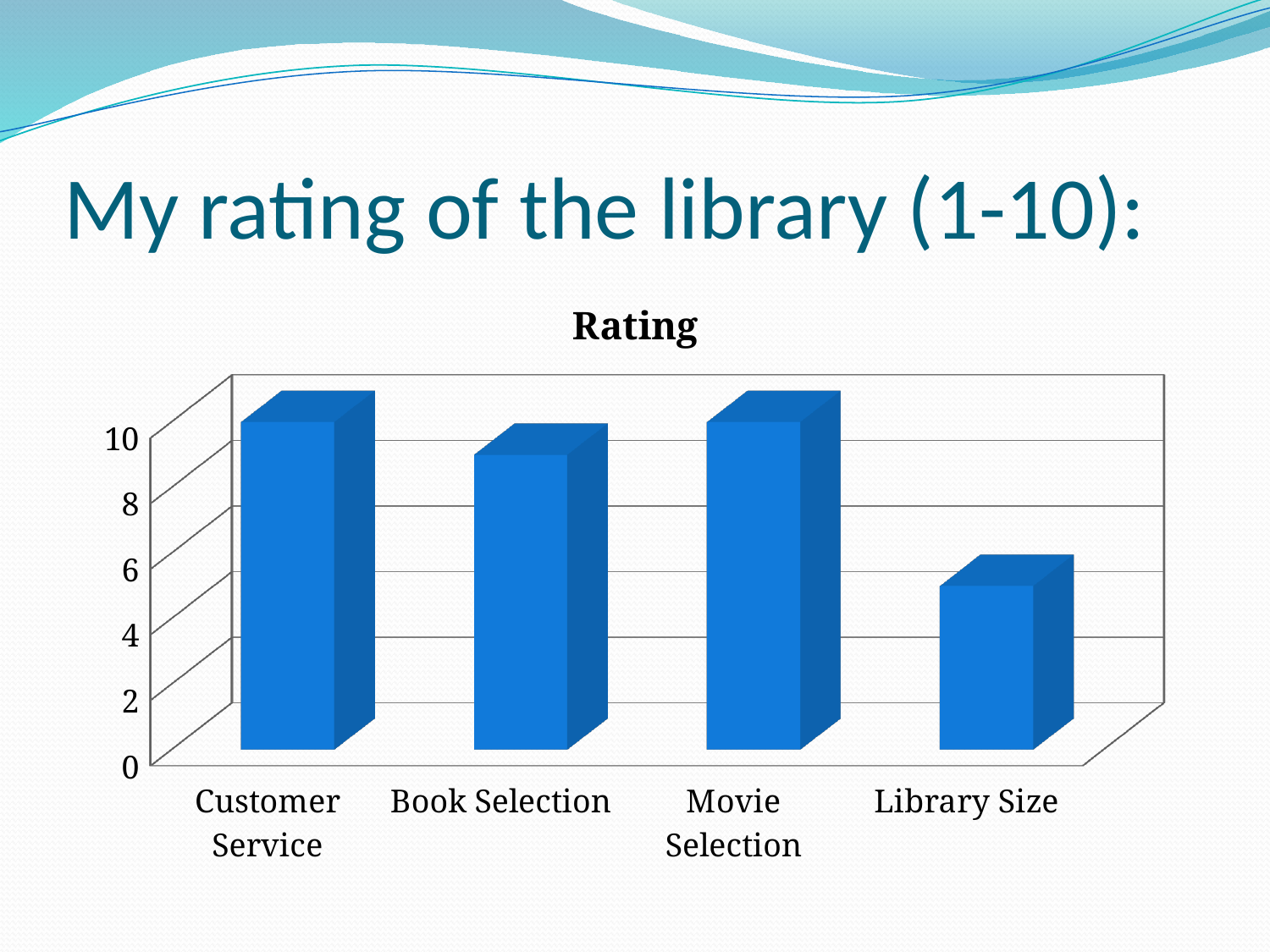
Which category has the lowest rating? Library Size Which is rated higher, Customer Service or Book Selection? Customer Service What kind of chart is shown on the slide? bar chart Is the value for Movie Selection greater or less than 6? greater Is the value for Library Size greater or less than 4? greater Is the value for Book Selection greater or less than 8? greater How many categories are shown on the chart? 4 Which is rated higher, Book Selection or Library Size? Book Selection What is the highest value shown on the vertical axis? 10 What is the title of the chart? Rating